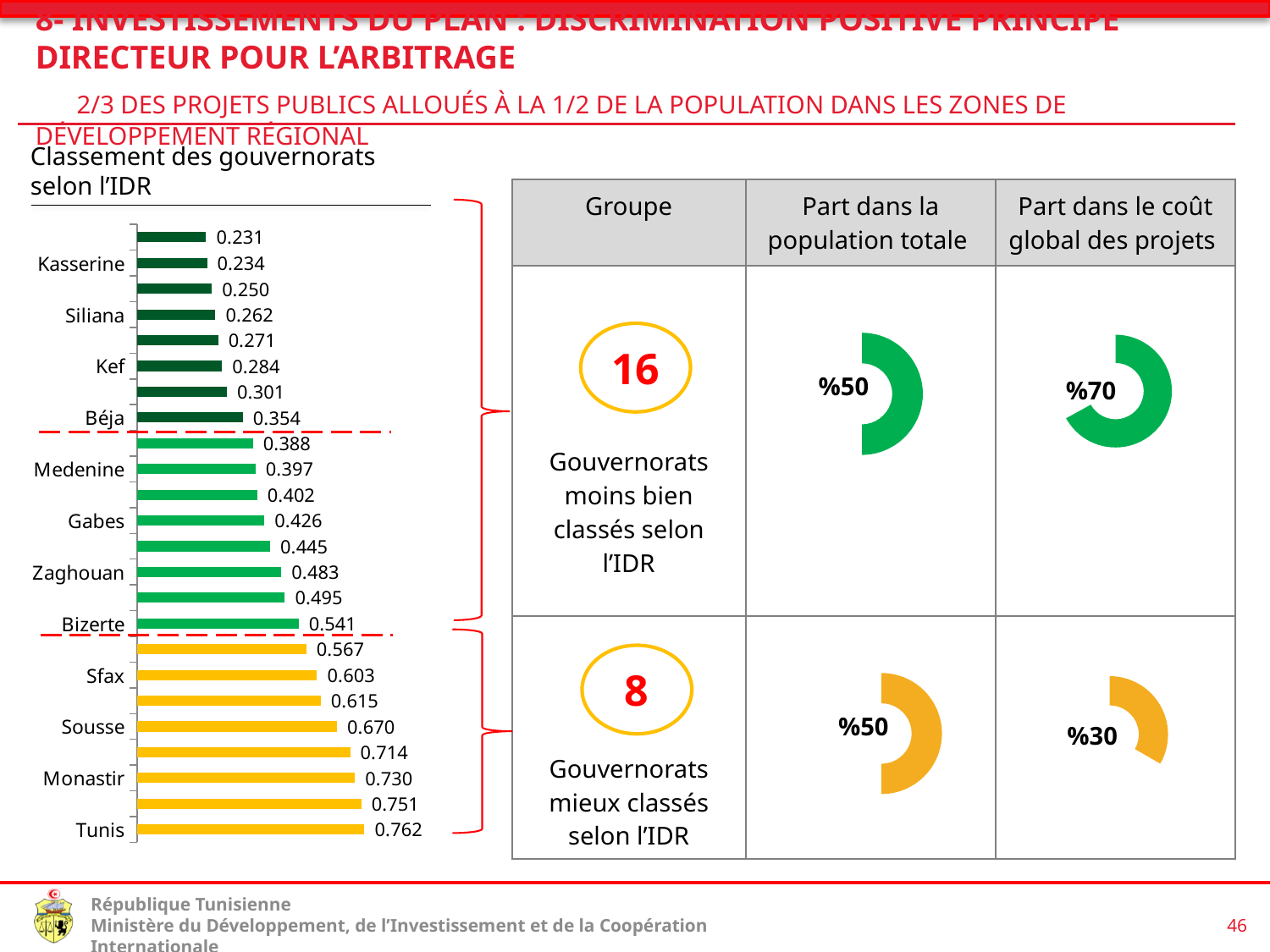
In the bar chart 'Classement des gouvernorats selon l'IDR', what is the difference between the values for Tunis and Kasserine? 0.528 In the bar chart 'Classement des gouvernorats selon l'IDR', which has the larger value, Monastir or Gabes? Monastir In the bar chart 'Classement des gouvernorats selon l'IDR', what is the smallest value shown? 0.231 In the bar chart 'Classement des gouvernorats selon l'IDR', what is the value for Kasserine? 0.234 How many bars are plotted in the bar chart 'Classement des gouvernorats selon l'IDR'? 24 In the bar chart 'Classement des gouvernorats selon l'IDR', what is the value for Bizerte? 0.541 In the bar chart 'Classement des gouvernorats selon l'IDR', what is the value for Tunis? 0.762 What kind of chart is 'Classement des gouvernorats selon l'IDR'? Bar chart In the bar chart 'Classement des gouvernorats selon l'IDR', what is the value for Sousse? 0.670 In the bar chart 'Classement des gouvernorats selon l'IDR', which labelled governorate has the highest value? Tunis In the table on the right, what is the 'Part dans le coût global des projets' shown for the group of 16 'Gouvernorats moins bien classés selon l'IDR'? %70 In the table on the right, what is the 'Part dans la population totale' shown for the group of 8 'Gouvernorats mieux classés selon l'IDR'? %50